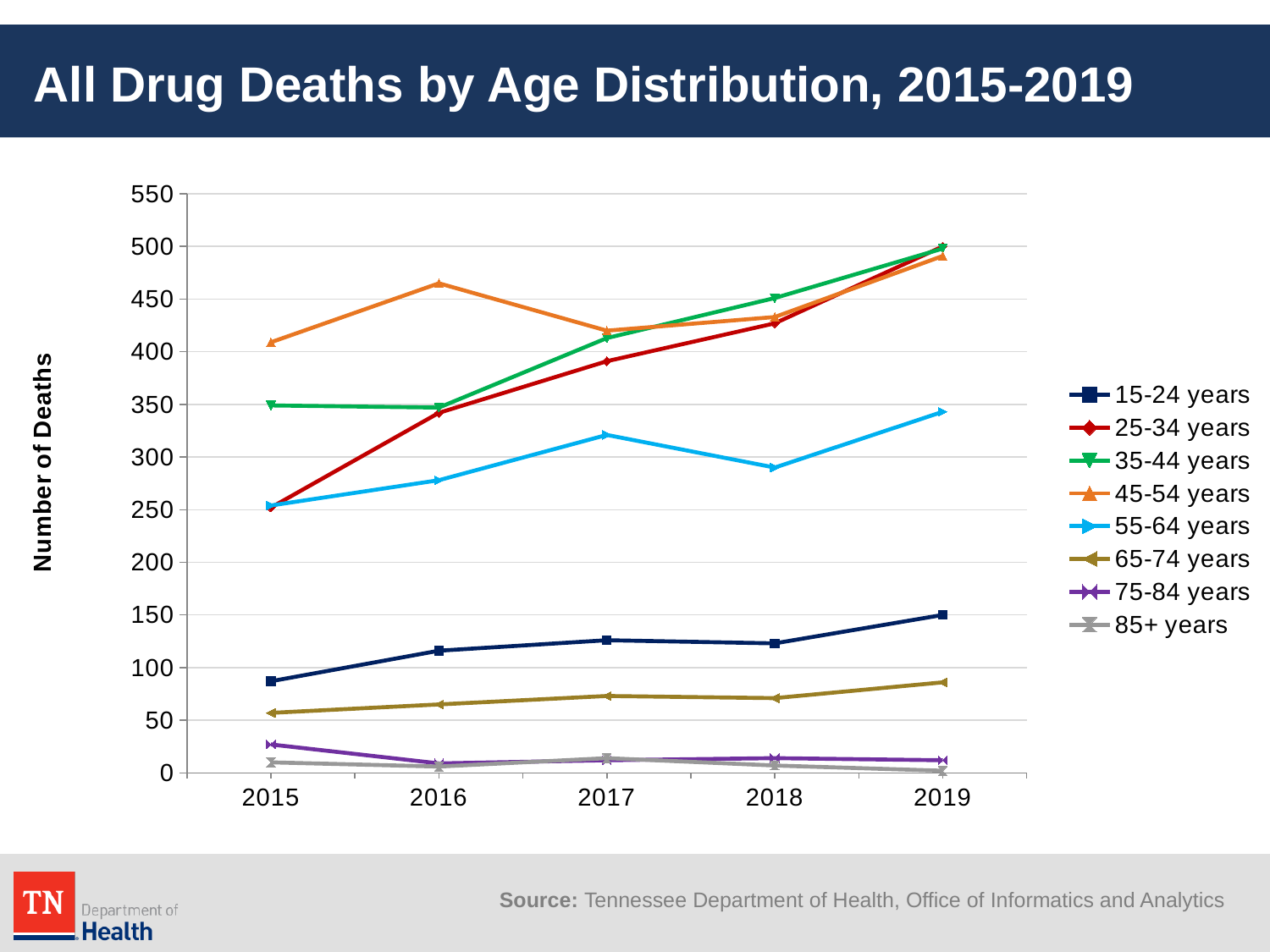
Do the values for 25-34 years rise or fall from 2015 to 2019? rise How many years are plotted along the x axis? 5 What is the label on the vertical axis? Number of Deaths In 2017, which had more deaths: 25-34 years or 55-64 years? 25-34 years Is the value for 55-64 years in 2019 greater or less than 300? greater How many age groups does the legend list? 8 Which age group had the lowest number of deaths in 2015? 85+ years Is the value for 15-24 years in 2015 greater or less than 100? less Is the value for 65-74 years in 2019 greater or less than 100? less What kind of chart is shown on the slide? line chart Which age group had the highest number of deaths in 2015? 45-54 years